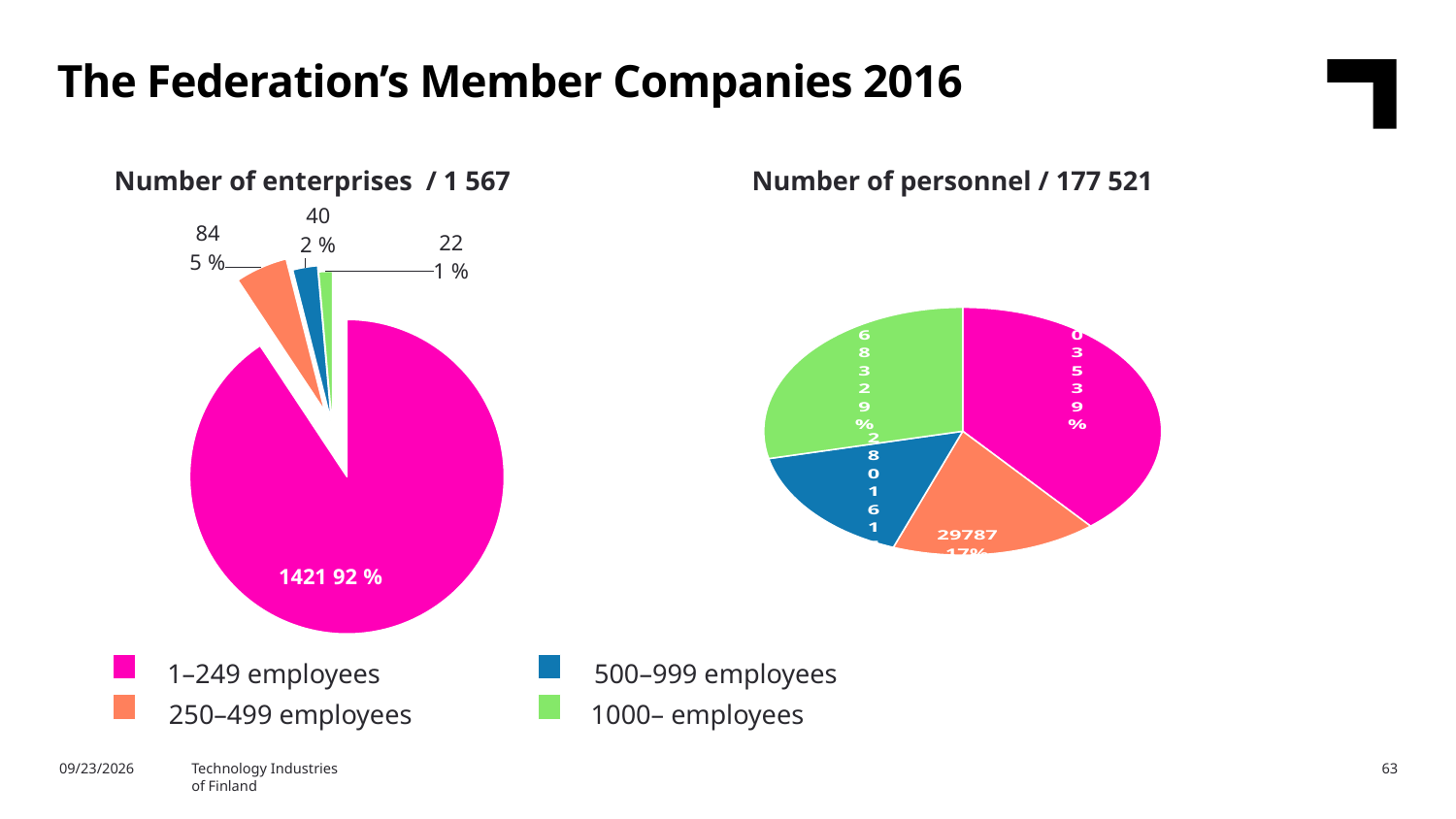
In the 'Number of personnel' chart on the right, how many personnel are in the 250–499 employees category? 29787 In the 'Number of enterprises' chart, what is the difference between the number of enterprises with 250–499 employees and those with 500–999 employees? 44 In the 'Number of enterprises' chart, which employee-size category has the smallest slice? 1000– employees In the 'Number of enterprises' chart, how many enterprises have 1–249 employees? 1421 In the 'Number of enterprises' chart, how many enterprises have 500–999 employees? 40 How many slices does the 'Number of enterprises' chart have? 4 What total number of personnel is given in the title of the right-hand chart? 177 521 In the 'Number of enterprises' chart, what share of the pie do enterprises with 1–249 employees make up? 92 % What kind of chart is the 'Number of enterprises' chart on the left? pie chart In the 'Number of enterprises' chart, what share of the pie do enterprises with 1000– employees make up? 1 % In the 'Number of enterprises' chart, which employee-size category has the largest slice? 1–249 employees In the 'Number of enterprises' chart, how many enterprises have 250–499 employees? 84